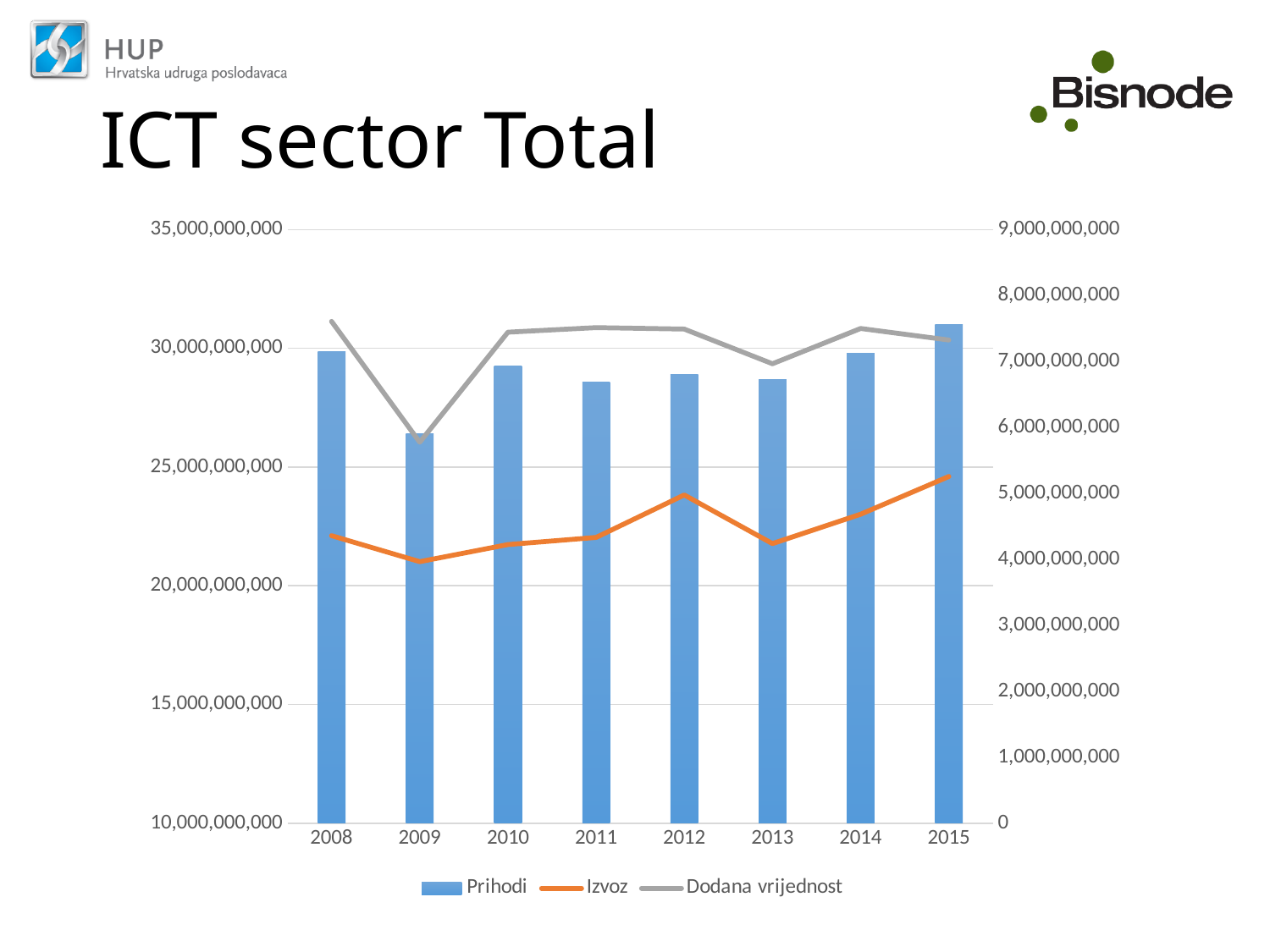
How many years are shown on the x axis? 8 Is the Prihodi value for 2009 greater or less than 30,000,000,000? less How many series does the legend list? 3 Which year has the lowest Prihodi bar? 2009 Does Izvoz rise or fall from 2013 to 2015? rise Which year has the larger Prihodi value, 2008 or 2009? 2008 In which year is Izvoz at its highest? 2015 What is the title of the chart? ICT sector Total Which year has the highest Prihodi bar? 2015 In which year is Dodana vrijednost at its lowest? 2009 Is the Izvoz value for 2012 greater or less than 4,000,000,000 on the right axis? greater What kind of chart is this? Combined bar and line chart